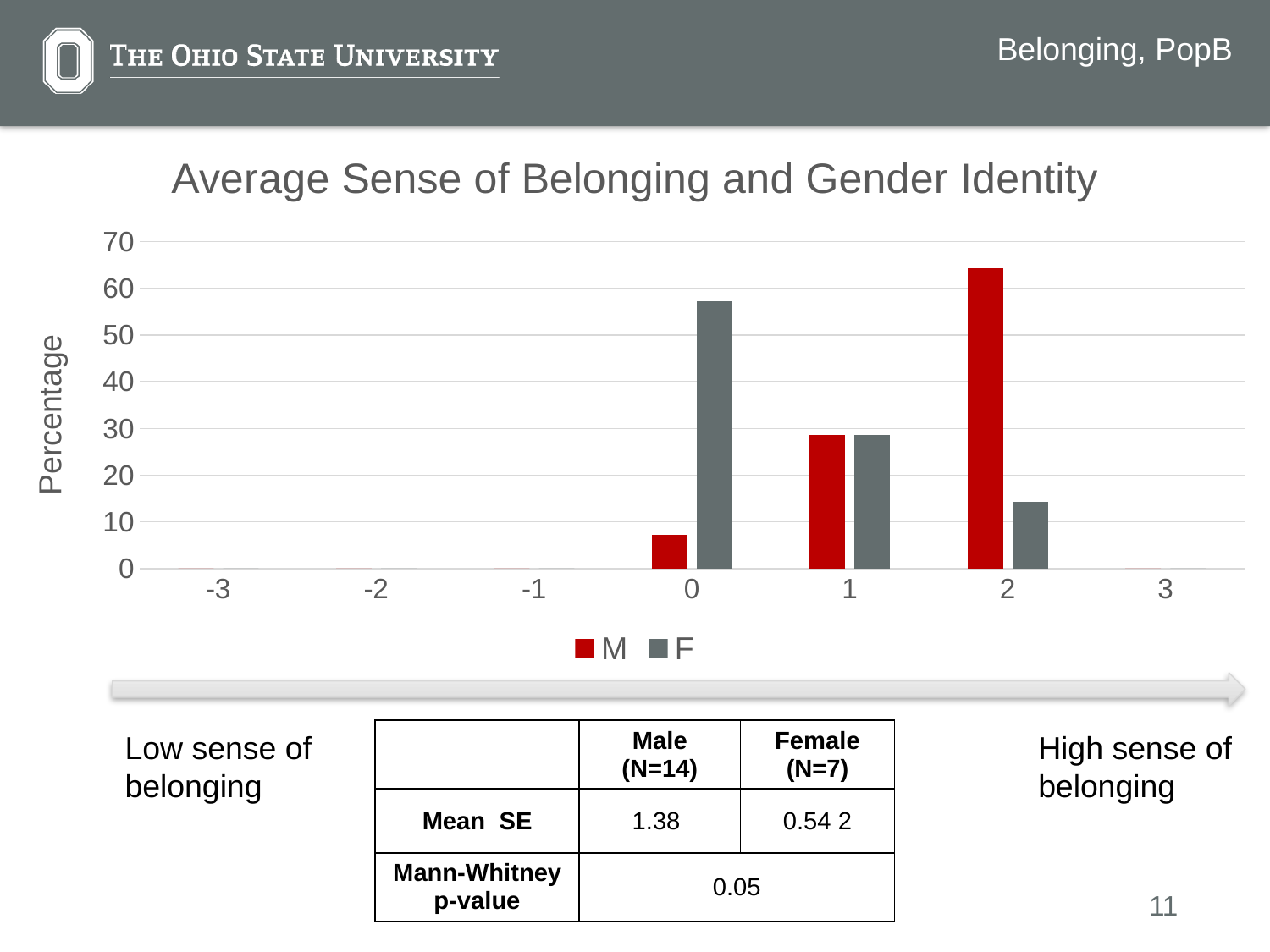
How many categories are shown along the x axis? 7 At which x-axis category is the M series highest? 2 How many series does the legend list? 2 At which x-axis category is the F series highest? 0 At category 2, which series has the larger value, M or F? M Is the value for M at category 2 greater or less than 60? greater Is the value for F at category 0 greater or less than 50? greater At category 0, which series has the larger value, M or F? F What kind of chart is shown on the slide? bar chart Is the value for M at category 0 greater or less than 10? less What is the title of the chart? Average Sense of Belonging and Gender Identity Which series is shown in red in the legend? M